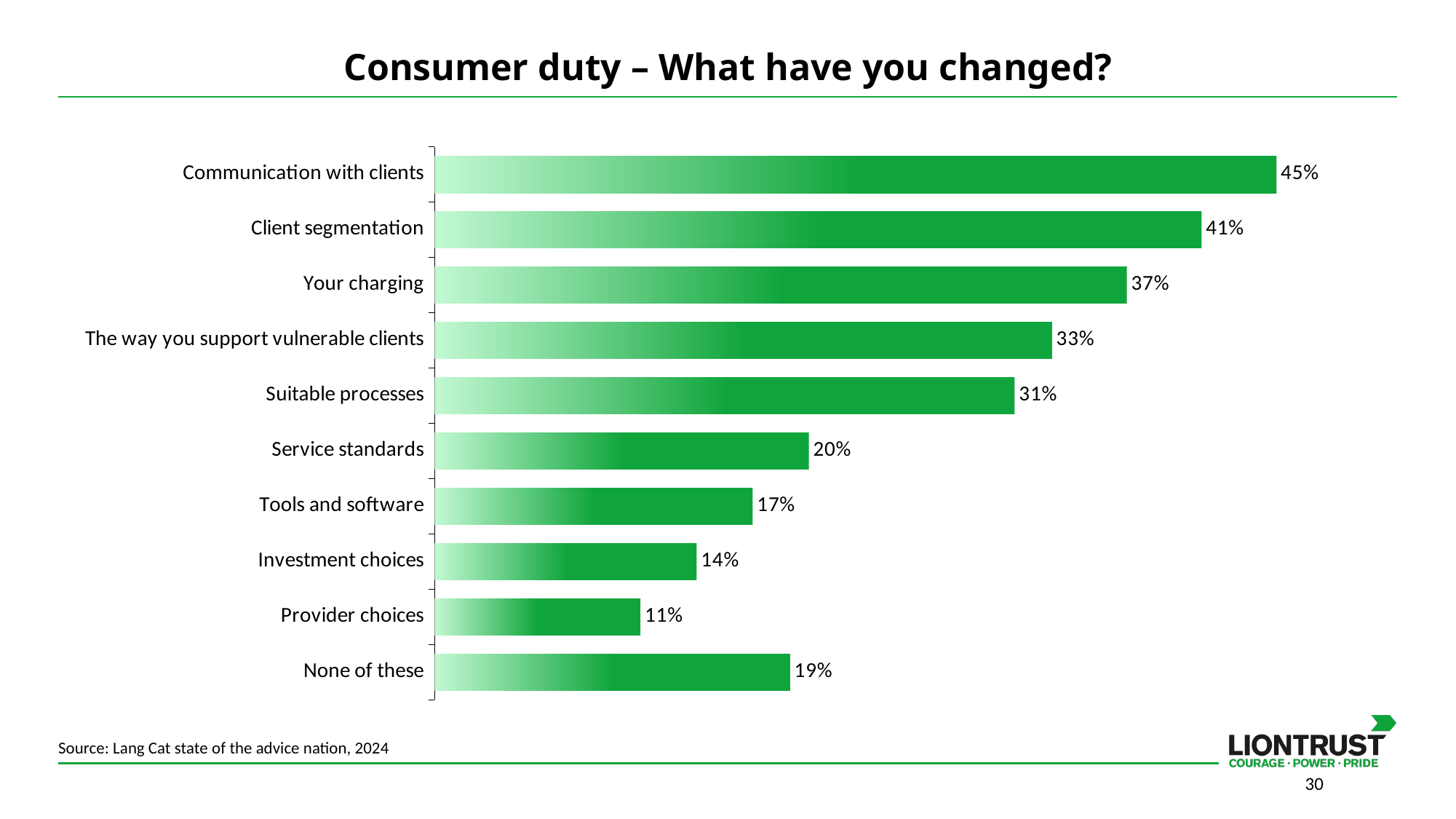
How many categories are shown in the chart? 10 What is the value for 'Provider choices'? 11% Which category has the highest value? Communication with clients Which is larger: 'Service standards' or 'None of these'? Service standards What is the difference between 'Client segmentation' and 'Your charging'? 4% What is the source cited for the chart data? Lang Cat state of the advice nation, 2024 What kind of chart is shown on the slide? Bar chart Which category has the lowest value? Provider choices Which is larger: 'Tools and software' or 'Investment choices'? Tools and software What is the difference between 'Communication with clients' and 'Provider choices'? 34% What percentage of respondents changed their communication with clients? 45% What is the value for 'None of these'? 19%